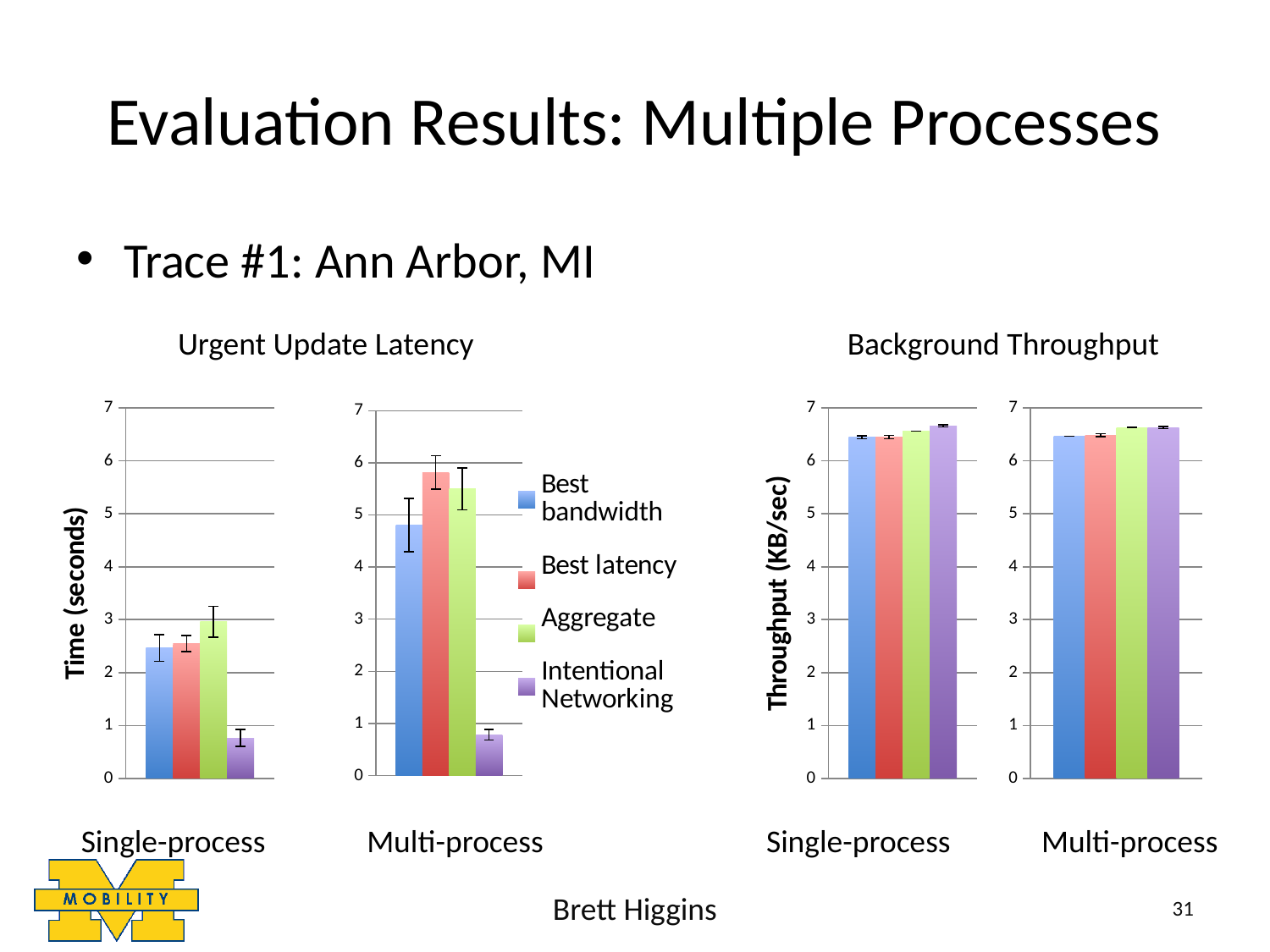
In the Urgent Update Latency Single-process chart, is the value for Intentional Networking greater or less than 1? less In the Urgent Update Latency Multi-process chart, is the value for Best bandwidth greater or less than 4? greater What is the y-axis label of the Background Throughput charts? Throughput (KB/sec) In the Urgent Update Latency Single-process chart, which series has the lowest value? Intentional Networking In the Urgent Update Latency Multi-process chart, which series has the lowest value? Intentional Networking In the Background Throughput Single-process chart, is the value for Best bandwidth greater or less than 6? greater What kind of chart is the Urgent Update Latency Multi-process chart? bar chart In the Urgent Update Latency Multi-process chart, which is larger, Best latency or Intentional Networking? Best latency How many series does the legend list for the charts on this slide? 4 In the Urgent Update Latency Single-process chart, which series has the highest value? Aggregate